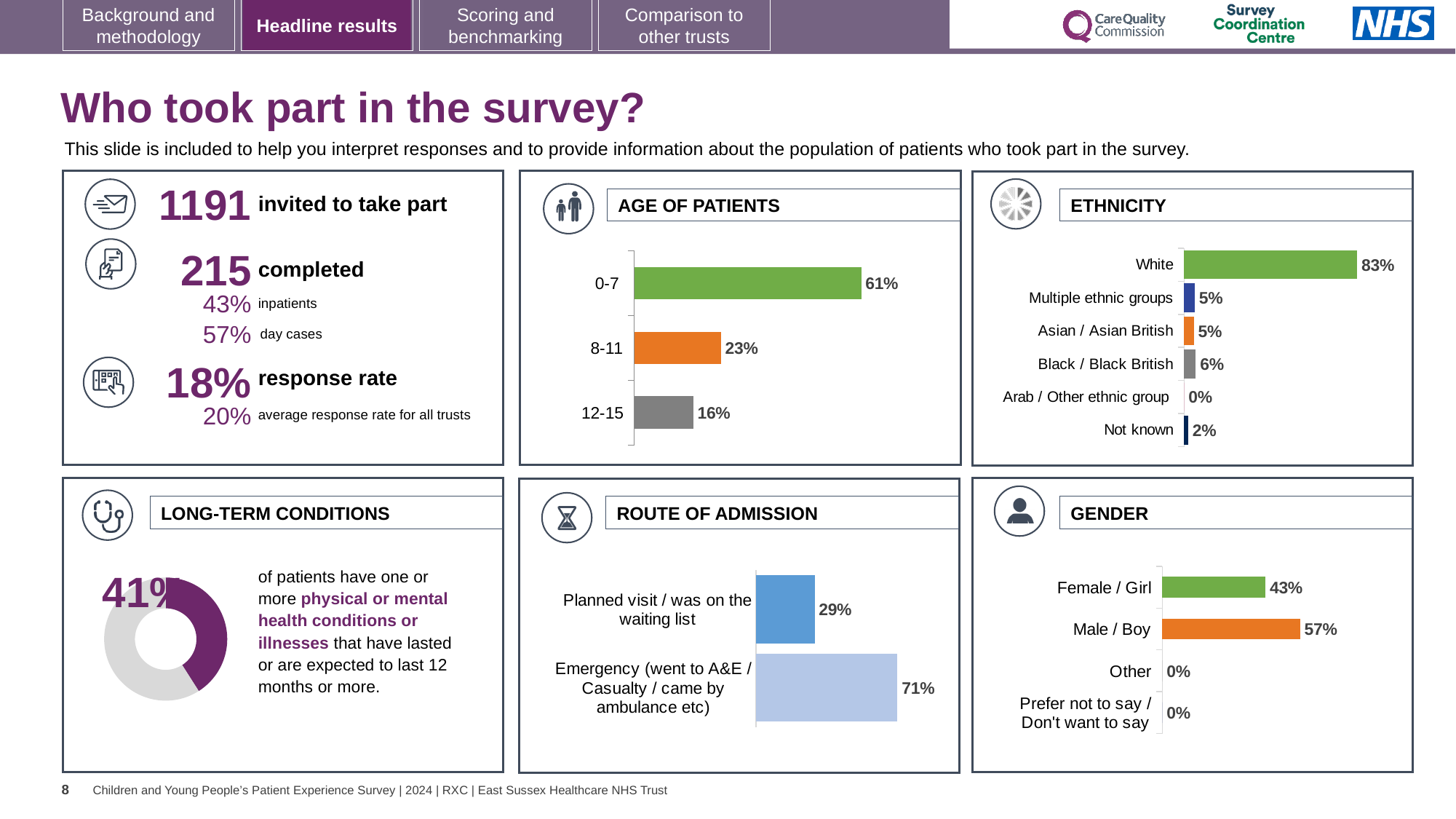
In the ROUTE OF ADMISSION chart, what percentage of patients came via a planned visit / was on the waiting list? 29% In the ETHNICITY chart, how many ethnicity categories are shown? 6 In the ETHNICITY chart, what percentage of patients were White? 83% What kind of chart is used in the LONG-TERM CONDITIONS panel? Doughnut chart In the GENDER chart, what percentage of patients were Male / Boy? 57% In the ROUTE OF ADMISSION chart, which route has the higher percentage: Planned visit / was on the waiting list or Emergency? Emergency (went to A&E / Casualty / came by ambulance etc) In the AGE OF PATIENTS chart, what is the difference between the 0-7 and 8-11 percentages? 38% In the LONG-TERM CONDITIONS chart, what share of patients have one or more long-term conditions? 41% In the AGE OF PATIENTS chart, what percentage of patients were aged 0-7? 61% In the GENDER chart, what is the difference between the Male / Boy and Female / Girl percentages? 14% In the AGE OF PATIENTS chart, which age group has the lowest percentage? 12-15 In the ETHNICITY chart, what percentage is shown for Black / Black British? 6%